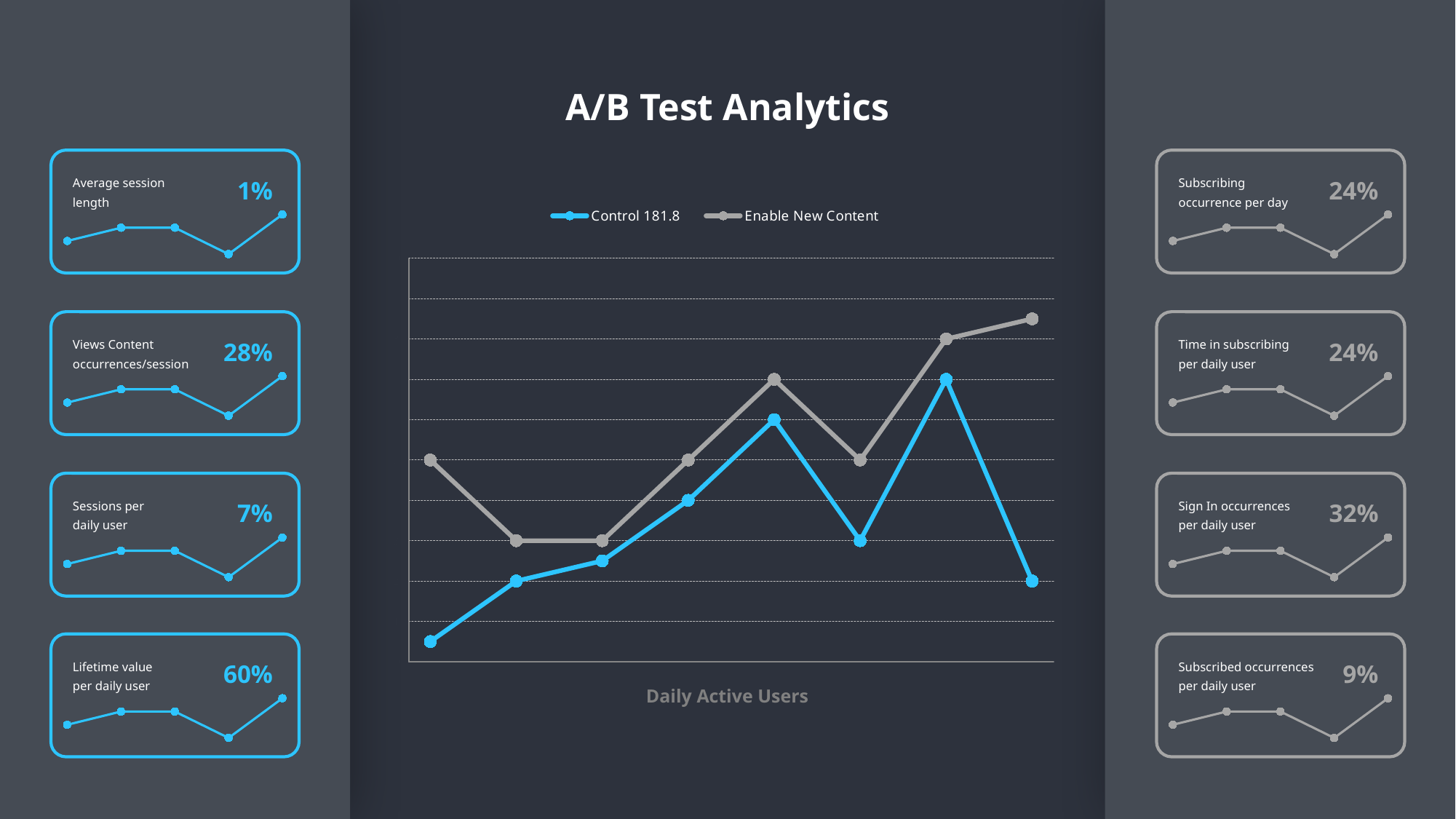
What kind of chart is the main chart under the title 'A/B Test Analytics'? line chart Which of the small cards on the slide shows the lowest percentage? Average session length How many data points does each series in the main line chart have? 8 What percentage is shown on the 'Lifetime value per daily user' card? 60% In the main line chart, which series has the higher value at the last data point? Enable New Content What is the x-axis title of the main line chart? Daily Active Users In the main line chart, which series has the higher value at the first data point? Enable New Content In the main line chart, which series has the lowest point on the chart? Control 181.8 What are the two series named in the legend of the main line chart? Control 181.8 and Enable New Content How many series does the legend of the main line chart list? 2 In the main line chart, which series reaches the highest point on the chart? Enable New Content What percentage is shown on the 'Sign In occurrences per daily user' card? 32%